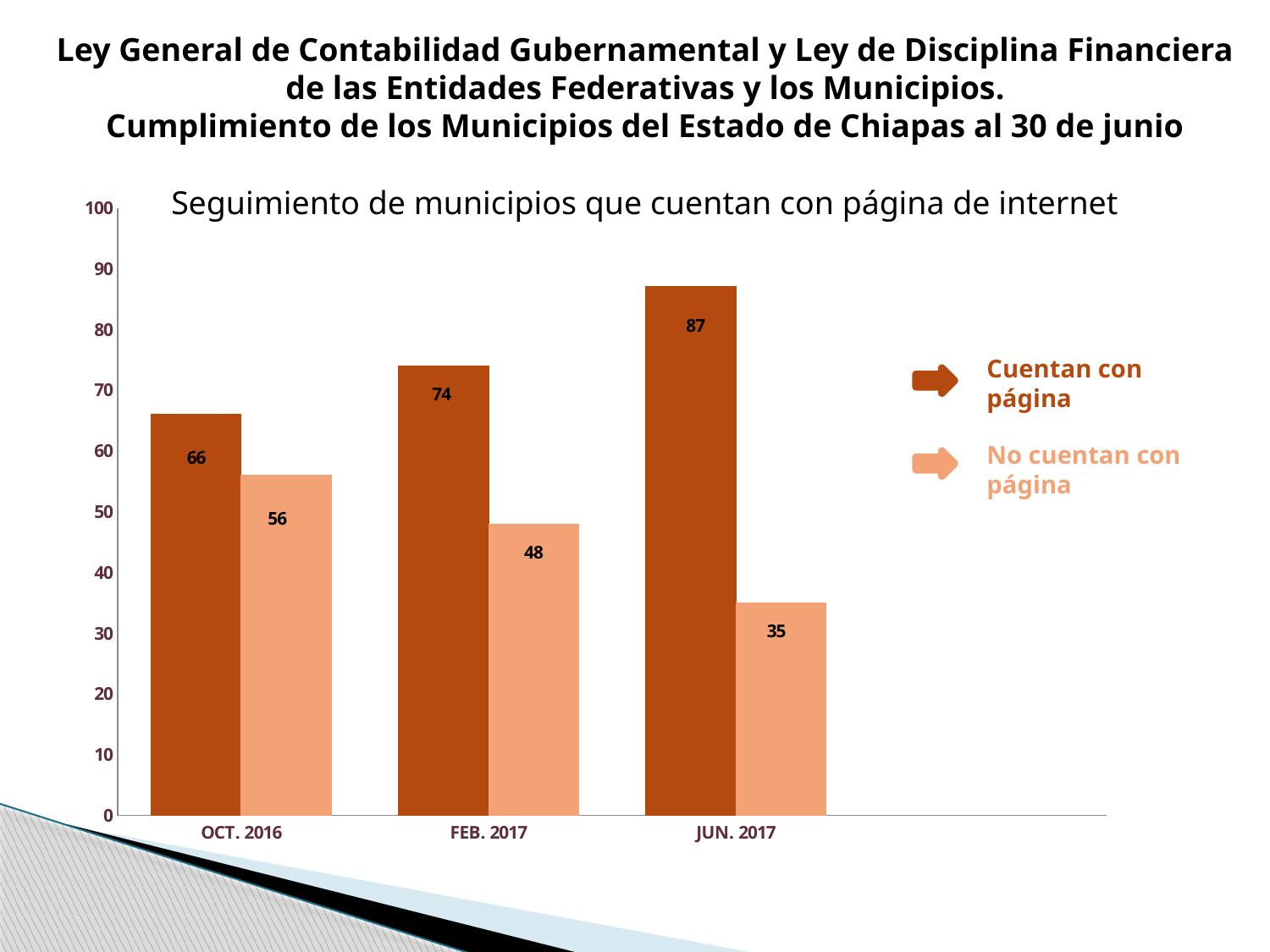
Is the value for 'Cuentan con página' in FEB. 2017 greater or less than 70? greater In which period is the 'Cuentan con página' value highest? JUN. 2017 What kind of chart is shown on the slide? Bar chart In which period is the 'No cuentan con página' value lowest? JUN. 2017 What is the value for 'Cuentan con página' in OCT. 2016? 66 Which is larger in OCT. 2016: 'Cuentan con página' or 'No cuentan con página'? Cuentan con página What is the difference between 'Cuentan con página' and 'No cuentan con página' in JUN. 2017? 52 What is the value for 'Cuentan con página' in JUN. 2017? 87 Does the 'No cuentan con página' series rise or fall from OCT. 2016 to JUN. 2017? Fall What is the value for 'No cuentan con página' in FEB. 2017? 48 How many periods are shown on the x axis? 3 How many series does the legend list? 2